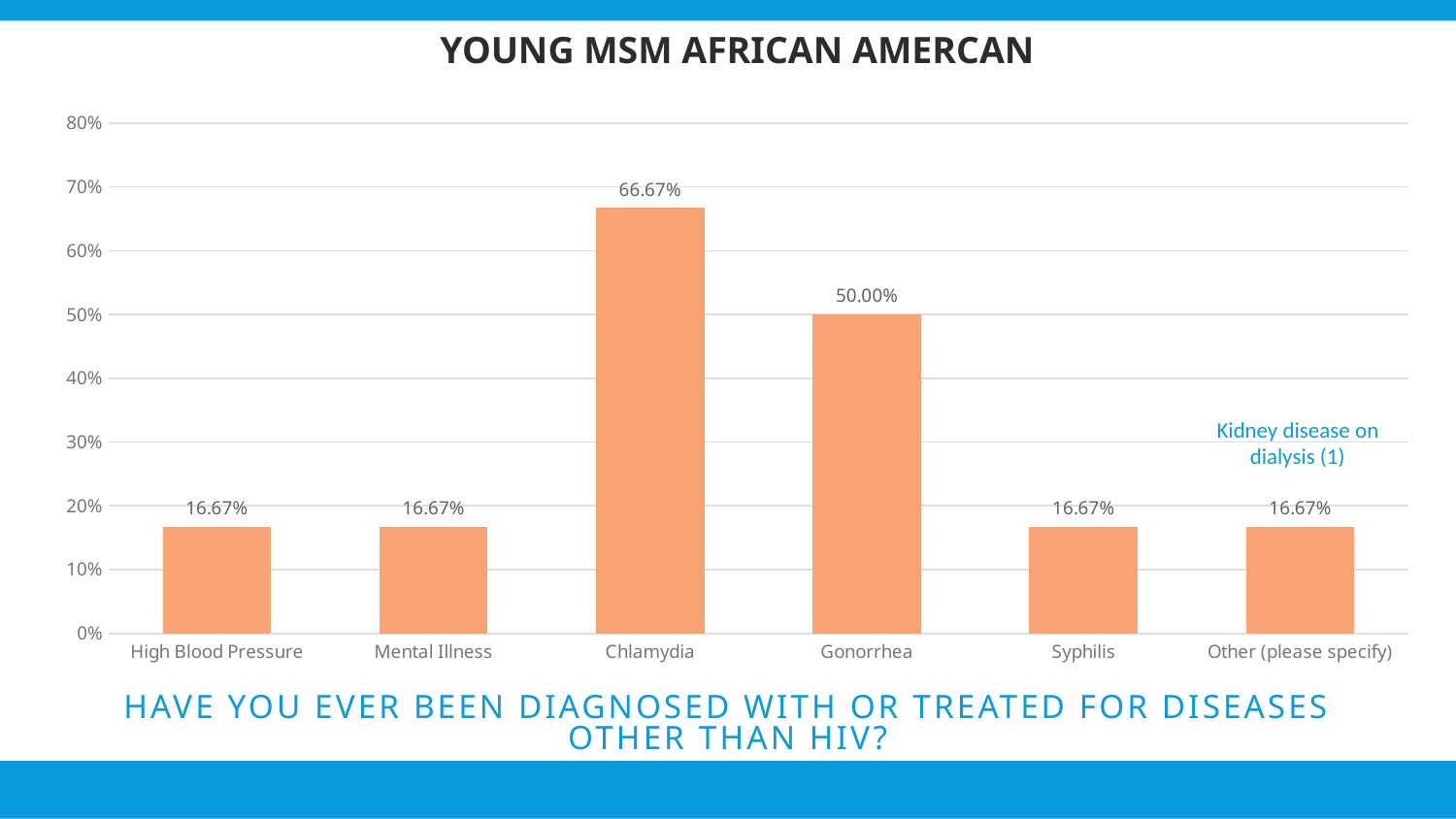
What is the title of the chart? YOUNG MSM AFRICAN AMERCAN Which is larger, the value for Gonorrhea or the value for Syphilis? Gonorrhea What is the value for Syphilis? 16.67% What is the difference between the values for Gonorrhea and Mental Illness? 33.33% What kind of chart is shown on the slide? bar chart What is the value for High Blood Pressure? 16.67% Is the value for Chlamydia greater or less than 60%? greater What is the difference between the values for Chlamydia and Gonorrhea? 16.67% What is the value for Chlamydia? 66.67% How many categories are shown on the x axis? 6 What is the value for Gonorrhea? 50.00% Which category has the highest value? Chlamydia